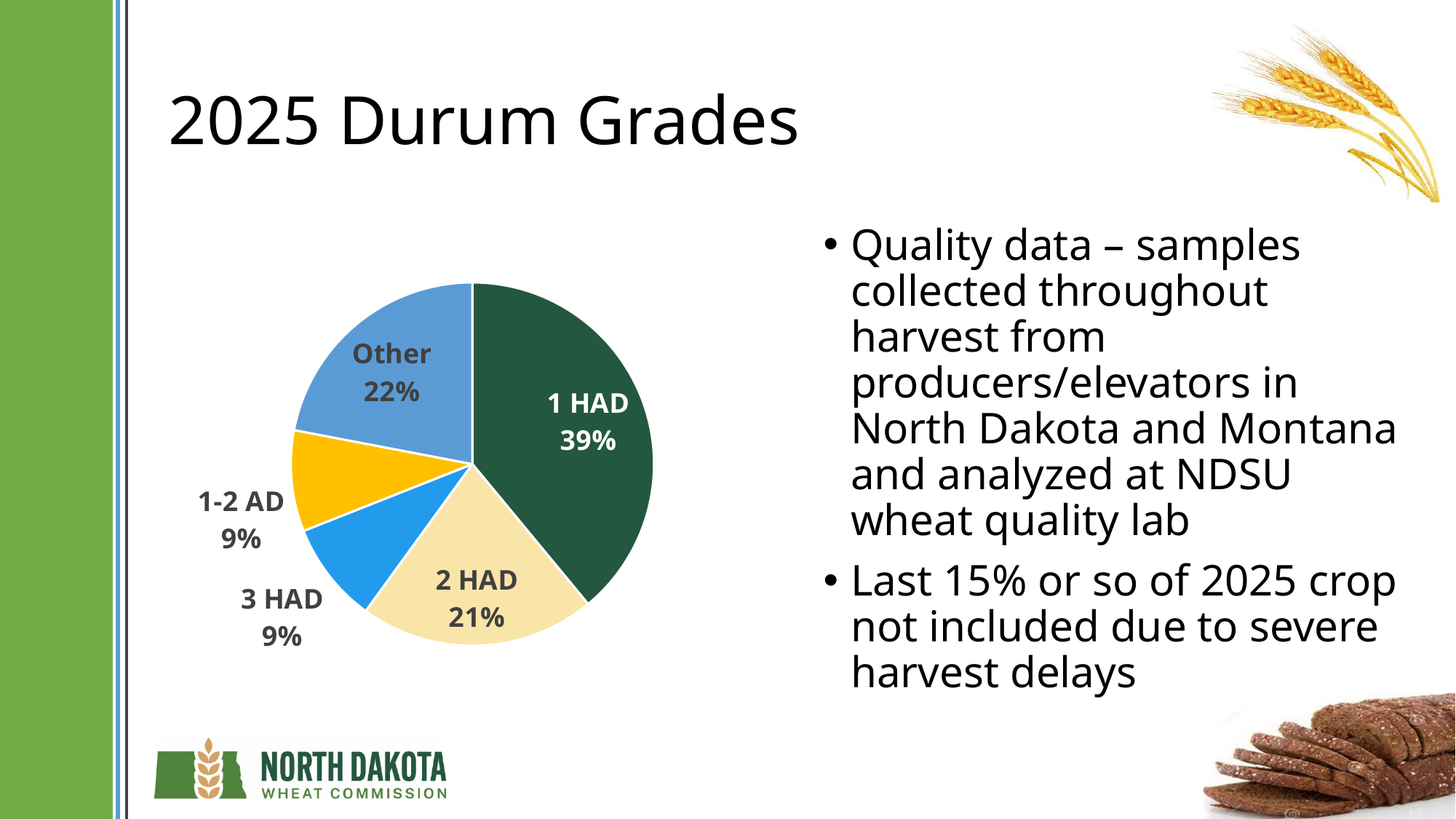
What share of the pie does 1 HAD represent? 39% What is the combined share of 1 HAD and 2 HAD? 60% How many categories are shown in the pie chart? 5 What share of the pie does 2 HAD represent? 21% What is the difference in percentage points between Other and 2 HAD? 1 What share of the pie does 3 HAD represent? 9% What is the difference in percentage points between 1 HAD and 2 HAD? 18 What share of the pie does Other represent? 22% Which grade category has the largest slice of the pie? 1 HAD Which is larger, the share for 1 HAD or the share for Other? 1 HAD What kind of chart is shown on the slide? Pie chart Which is larger, the share for Other or the share for 2 HAD? Other